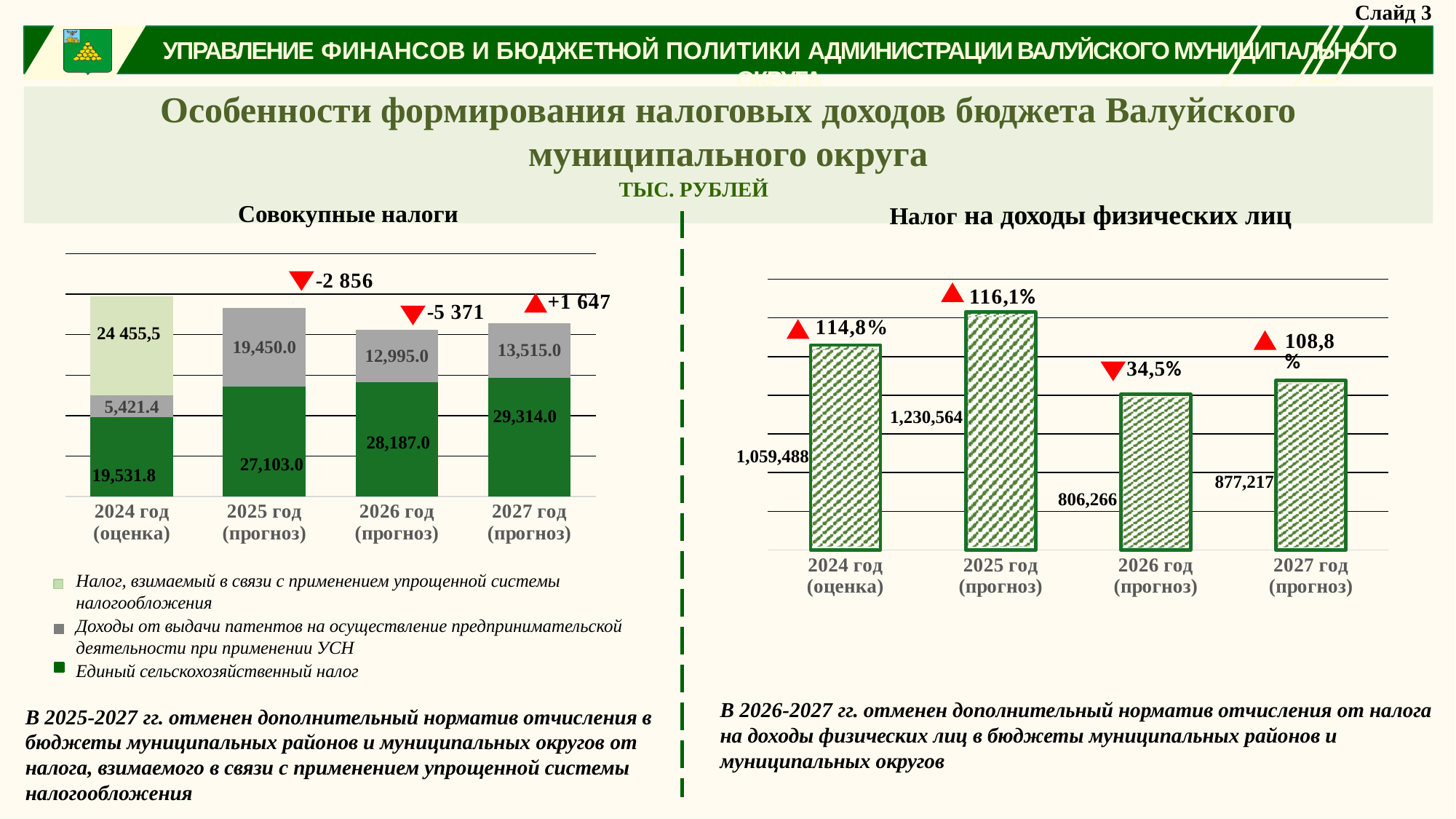
What kind of chart is the chart titled «Совокупные налоги»? Stacked bar chart On the chart titled «Совокупные налоги», what is the value of «Доходы от выдачи патентов на осуществление предпринимательской деятельности при применении УСН» for 2026 год (прогноз)? 12,995.0 On the chart titled «Налог на доходы физических лиц», what is the difference between the values for 2025 год (прогноз) and 2024 год (оценка)? 171,076 On the chart titled «Налог на доходы физических лиц», how many bars are plotted? 4 On the chart titled «Совокупные налоги», what is the value of «Налог, взимаемый в связи с применением упрощенной системы налогообложения» for 2024 год (оценка)? 24 455,5 On the chart titled «Совокупные налоги», how many series does the legend list? 3 On the chart titled «Налог на доходы физических лиц», what is the value for 2025 год (прогноз)? 1,230,564 On the chart titled «Совокупные налоги», what is the total of the stacked bar for 2027 год (прогноз)? 42,829.0 On the chart titled «Налог на доходы физических лиц», which is larger: the value for 2024 год (оценка) or 2027 год (прогноз)? 2024 год (оценка) On the chart titled «Налог на доходы физических лиц», which year has the lowest value? 2026 год (прогноз) On the chart titled «Совокупные налоги», which year has the highest value of «Единый сельскохозяйственный налог»? 2027 год (прогноз) On the chart titled «Совокупные налоги», what is the value of «Единый сельскохозяйственный налог» for 2025 год (прогноз)? 27,103.0